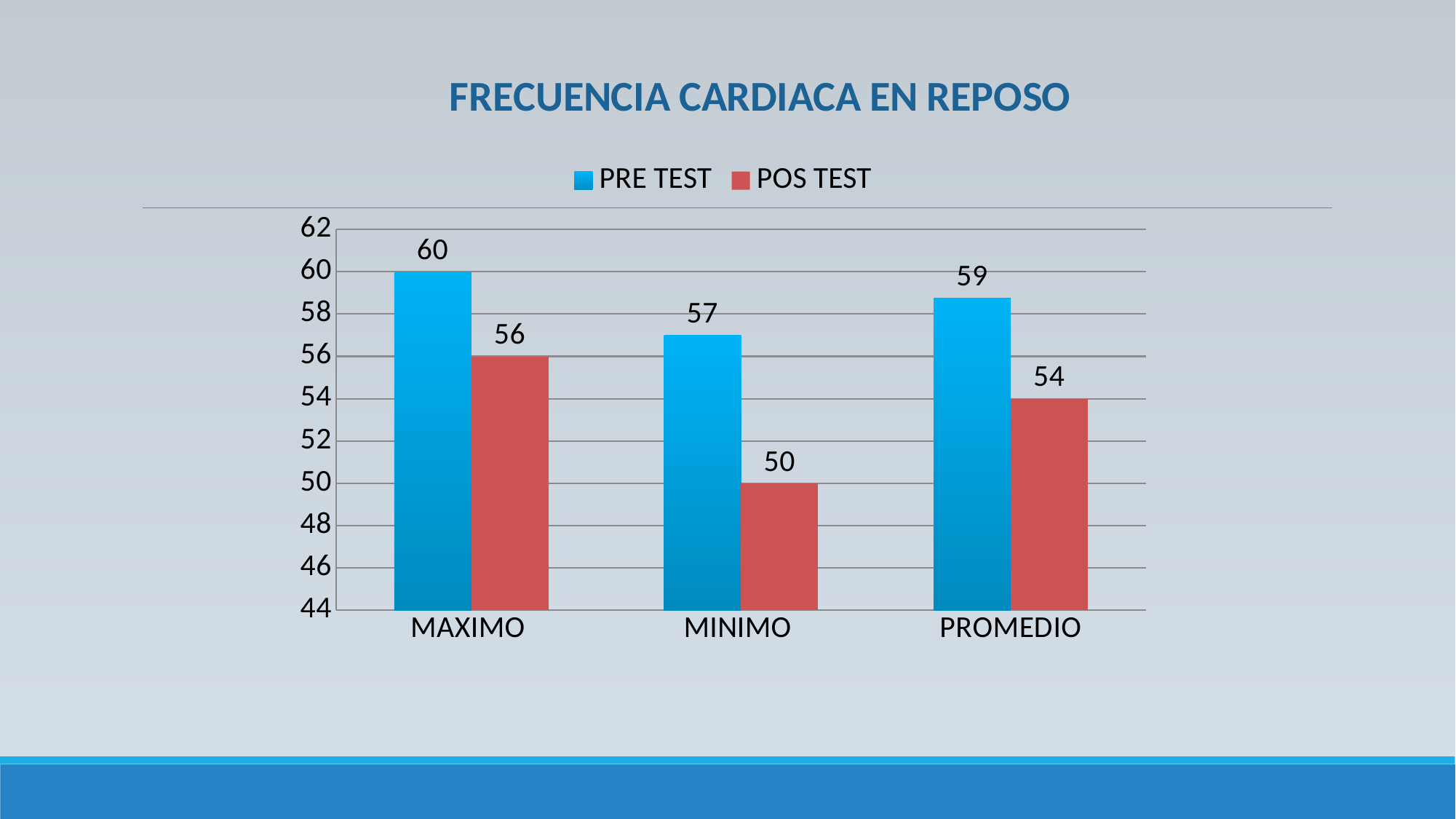
Which category has the highest PRE TEST value? MAXIMO What is the PRE TEST value for MAXIMO? 60 How many categories are shown on the x axis? 3 What is the difference between the PRE TEST and POS TEST values for PROMEDIO? 5 What is the difference between the PRE TEST and POS TEST values for MINIMO? 7 Which is larger for MAXIMO, the PRE TEST value or the POS TEST value? PRE TEST Which category has the lowest POS TEST value? MINIMO What is the POS TEST value for PROMEDIO? 54 How many series does the legend list? 2 What is the POS TEST value for MINIMO? 50 What is the title of the chart? FRECUENCIA CARDIACA EN REPOSO What kind of chart is shown on the slide? bar chart